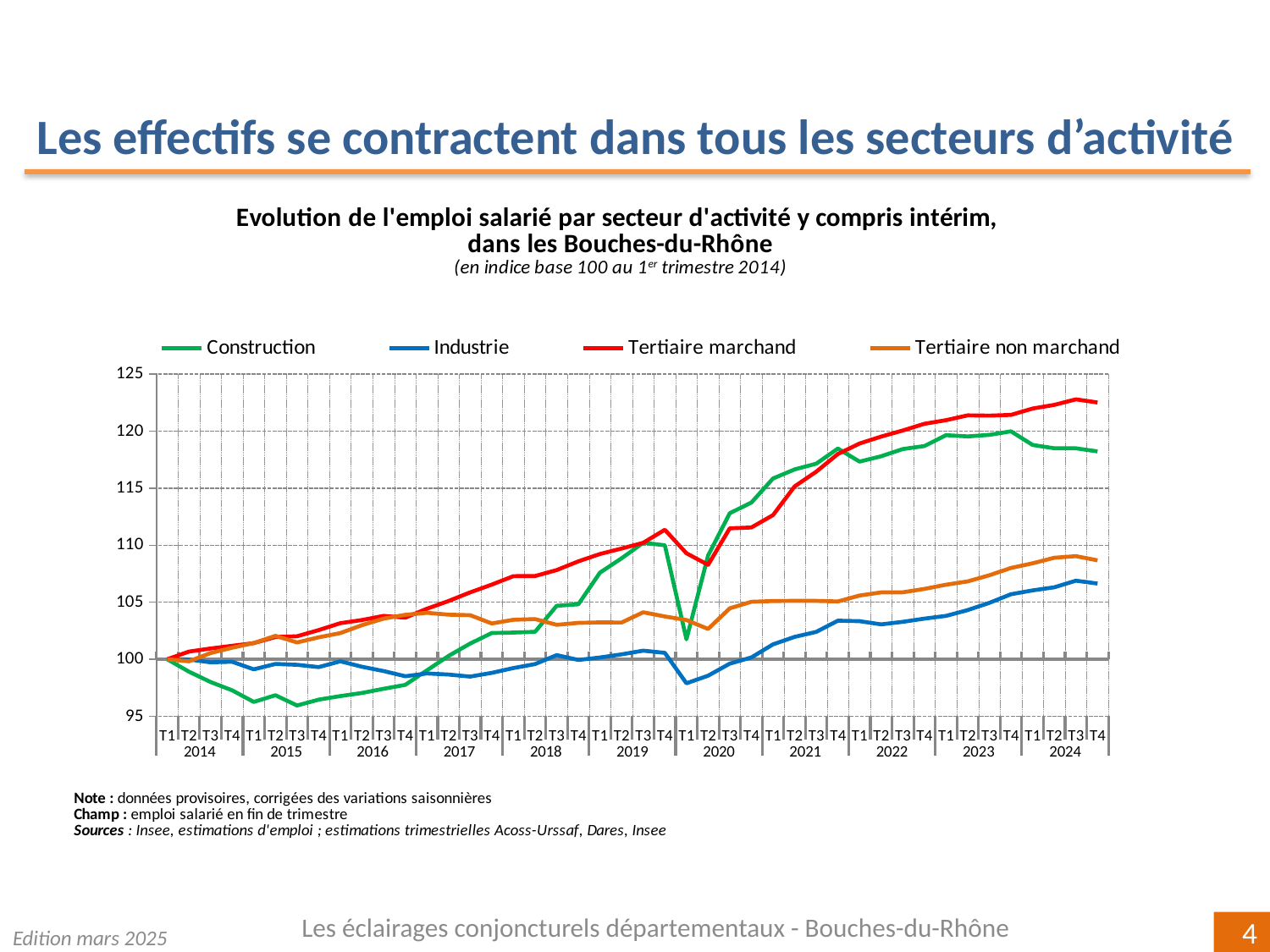
What colour is the Construction line? green At T4 2024, which is larger: Construction or Tertiaire non marchand? Construction Is the value for Industrie at T1 2020 greater or less than 100? less How many series does the legend list? 4 Is the value for Construction at T2 2015 greater or less than 100? less Which series has the highest value at T4 2024? Tertiaire marchand Does the Industrie series rise or fall between T1 2021 and T4 2024? rise What kind of chart is shown on the slide? line chart Is the value for Tertiaire marchand at T4 2024 greater or less than 120? greater Which series has the lowest value at T4 2024? Industrie What is the index value of all series at T1 2014? 100 How many years are shown along the x axis? 11